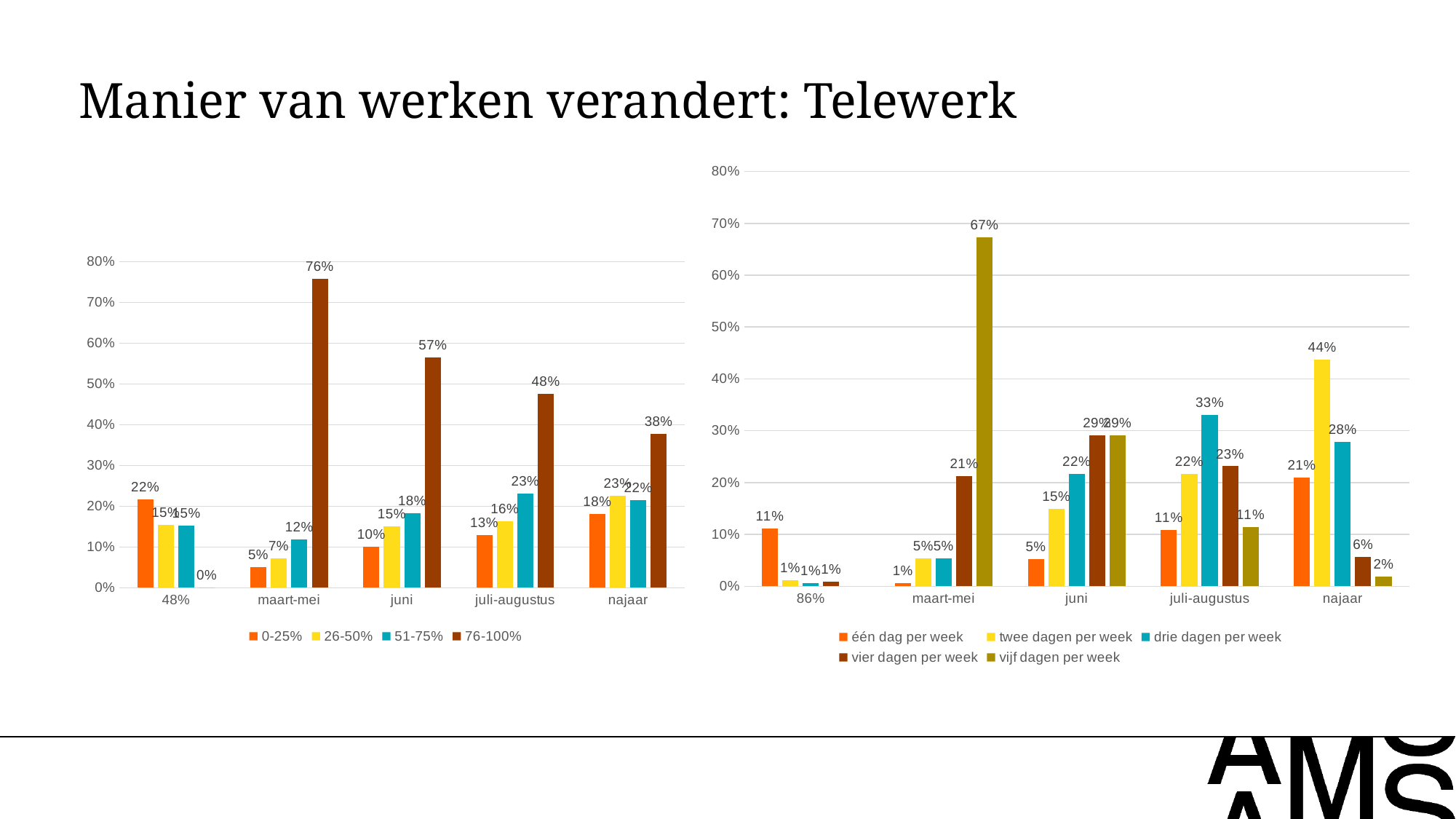
In the right chart, what is the value of vijf dagen per week for maart-mei? 67% In the right chart, which series has the highest value for juli-augustus? drie dagen per week In the right chart, what is the value of twee dagen per week for najaar? 44% In the left chart, how many series does the legend list? 4 In the left chart, what is the value of the 76-100% series for maart-mei? 76% In the right chart, which is larger for juni: twee dagen per week or drie dagen per week? drie dagen per week In the left chart, does the 76-100% value fall or rise from maart-mei to najaar? fall In the left chart, what is the difference between the 76-100% values for juni and najaar? 19% What kind of chart is the right chart? bar chart In the left chart, what is the value of the 51-75% series for juli-augustus? 23% In the right chart, how many series does the legend list? 5 In the left chart, which category has the highest value for the 76-100% series? maart-mei